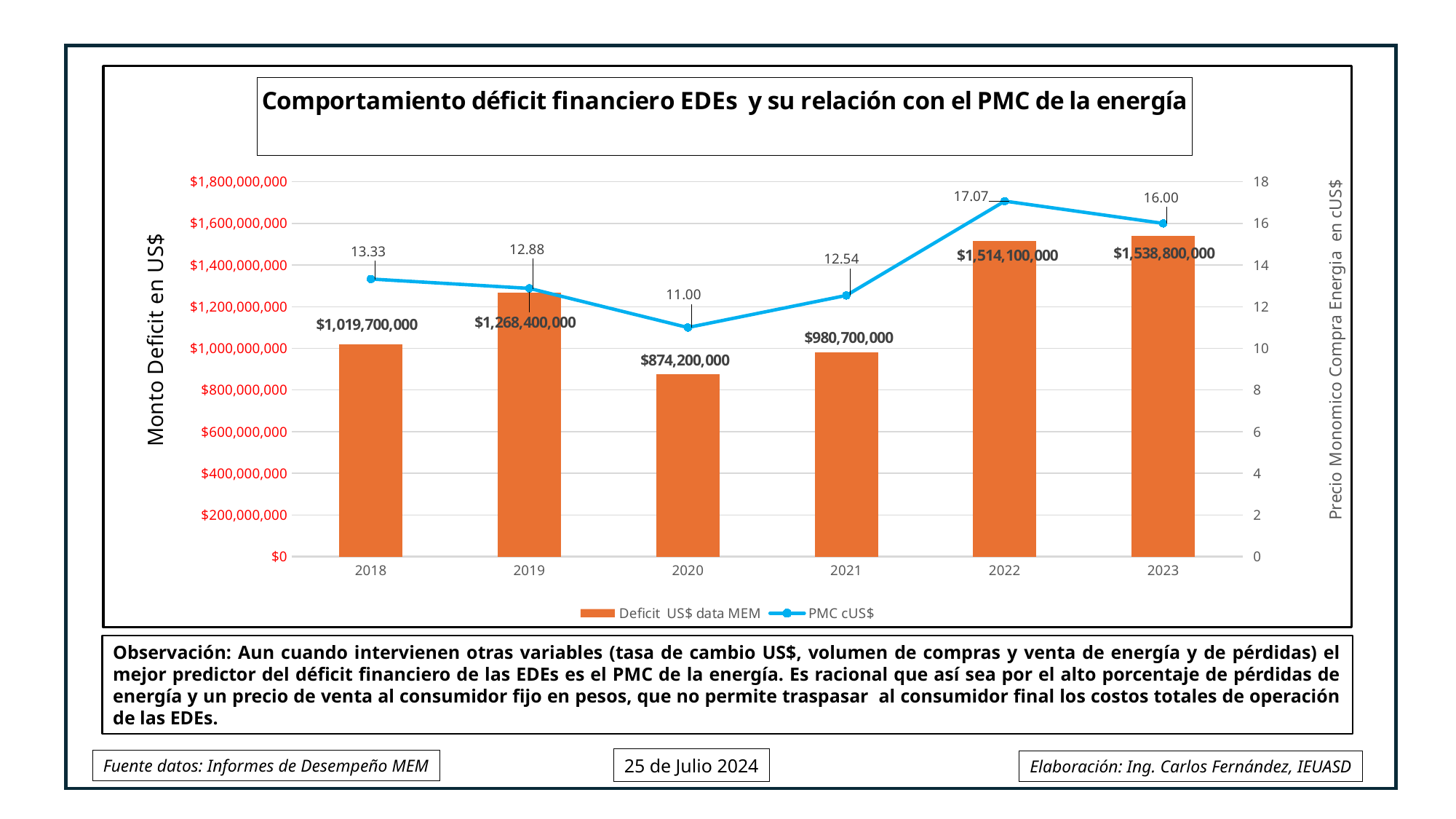
Which is larger, the deficit for 2018 or the deficit for 2021? 2018 Which year has the lowest PMC cUS$ value? 2020 What kind of chart is used to show the Deficit US$ data MEM series? bar chart How many series does the legend list? 2 How many years are shown on the x axis of the chart? 6 What is the PMC cUS$ value for 2022? 17.07 Is the deficit value for 2020 greater or less than $1,000,000,000? less Which year has the highest Deficit US$ data MEM value? 2023 What is the value of the Deficit US$ data MEM bar for 2019? $1,268,400,000 What is the deficit value shown for 2020? $874,200,000 What is the difference between the deficit values for 2023 and 2022? $24,700,000 What is the title of the chart? Comportamiento déficit financiero EDEs y su relación con el PMC de la energía